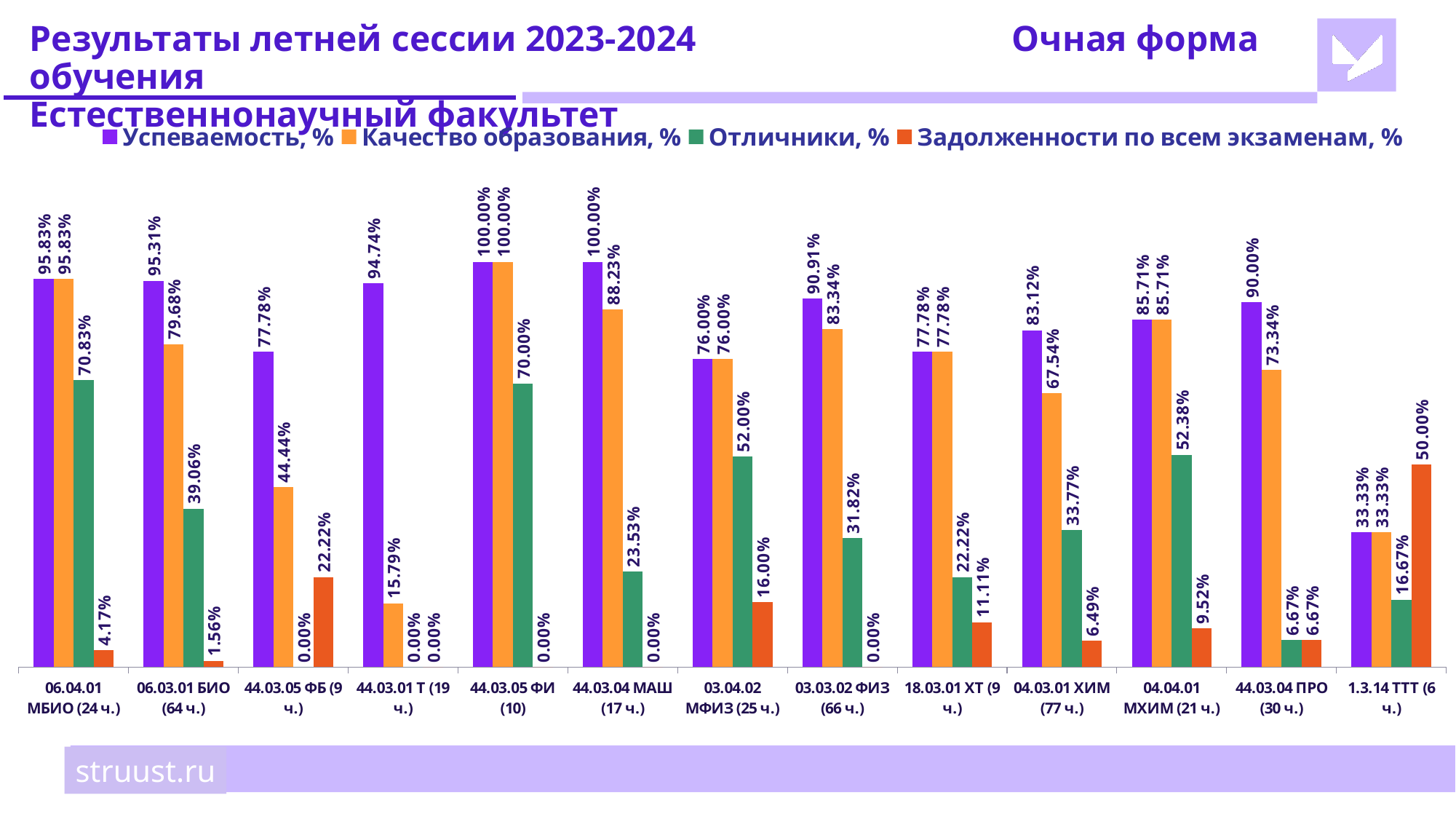
Which category has the highest Задолженности по всем экзаменам, % value? 1.3.14 ТТТ (6 ч.) Which is larger: the Отличники, % value for 06.04.01 МБИО (24 ч.) or for 44.03.05 ФИ (10)? 06.04.01 МБИО (24 ч.) What is the Успеваемость, % value for 03.03.02 ФИЗ (66 ч.)? 90.91% What is the Задолженности по всем экзаменам, % value for 44.03.05 ФБ (9 ч.)? 22.22% What is the Качество образования, % value for 44.03.04 МАШ (17 ч.)? 88.23% Which category has the lowest Успеваемость, % value? 1.3.14 ТТТ (6 ч.) What is the Отличники, % value for 04.04.01 МХИМ (21 ч.)? 52.38% How many categories are shown on the x axis? 13 How many series does the legend list? 4 What kind of chart is shown on the slide? Bar chart What is the difference between the Успеваемость, % and Качество образования, % values for 44.03.01 Т (19 ч.)? 78.95% Which colour represents the Отличники, % series in the legend? Green